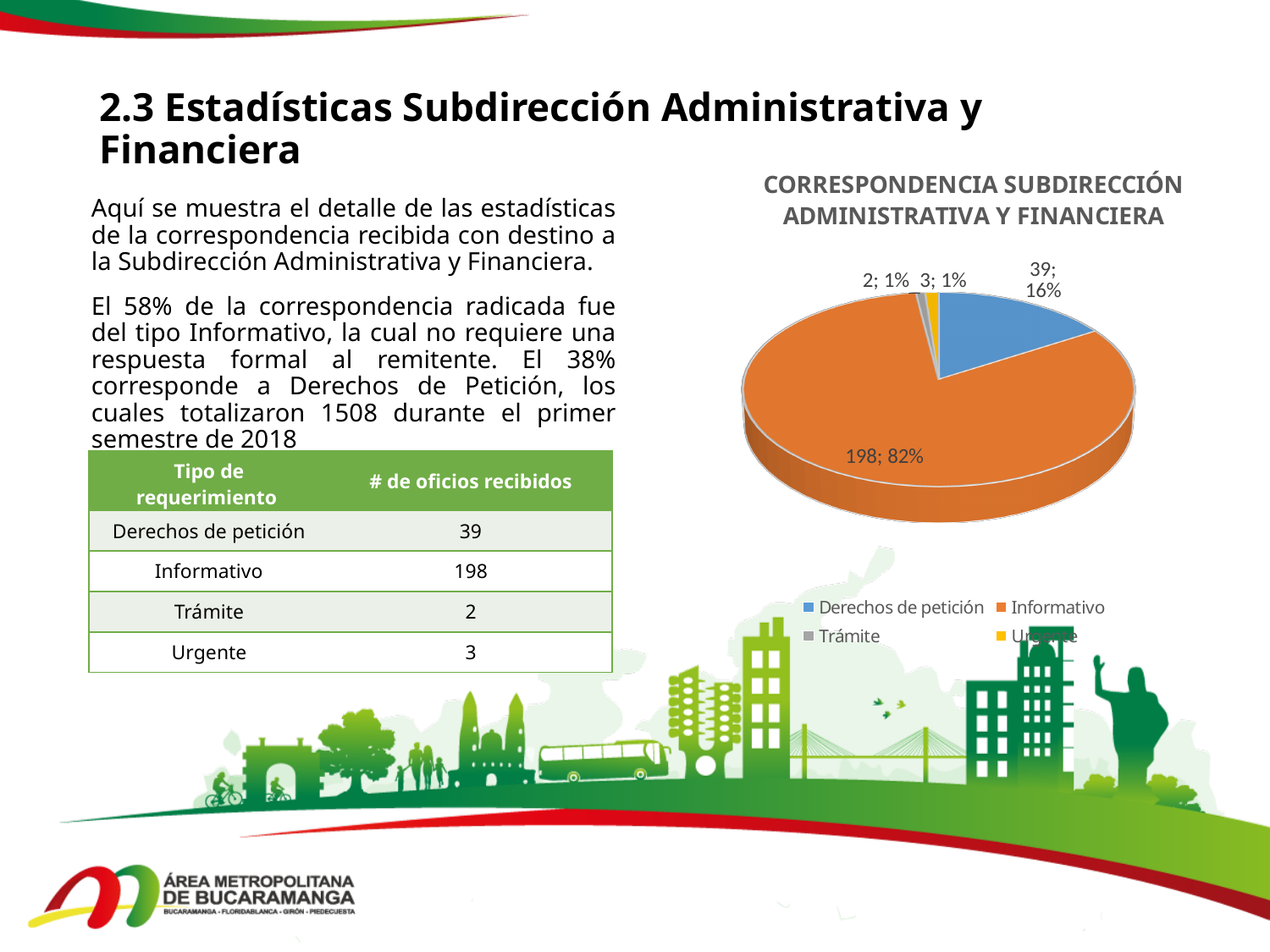
What value is shown for the Derechos de petición slice? 39 What percentage share does the Derechos de petición slice represent? 16% How many slices does the pie chart have? 4 What type of chart is shown on the slide? Pie chart What percentage share does the Informativo slice represent? 82% Which category has the largest slice in the pie chart? Informativo What value is shown for the Informativo slice? 198 Which is larger, the Urgente slice or the Trámite slice? Urgente What value is shown for the Urgente slice? 3 What is the difference between the Informativo value and the Derechos de petición value? 159 What is the title of the chart? CORRESPONDENCIA SUBDIRECCIÓN ADMINISTRATIVA Y FINANCIERA How many entries does the chart legend list? 4